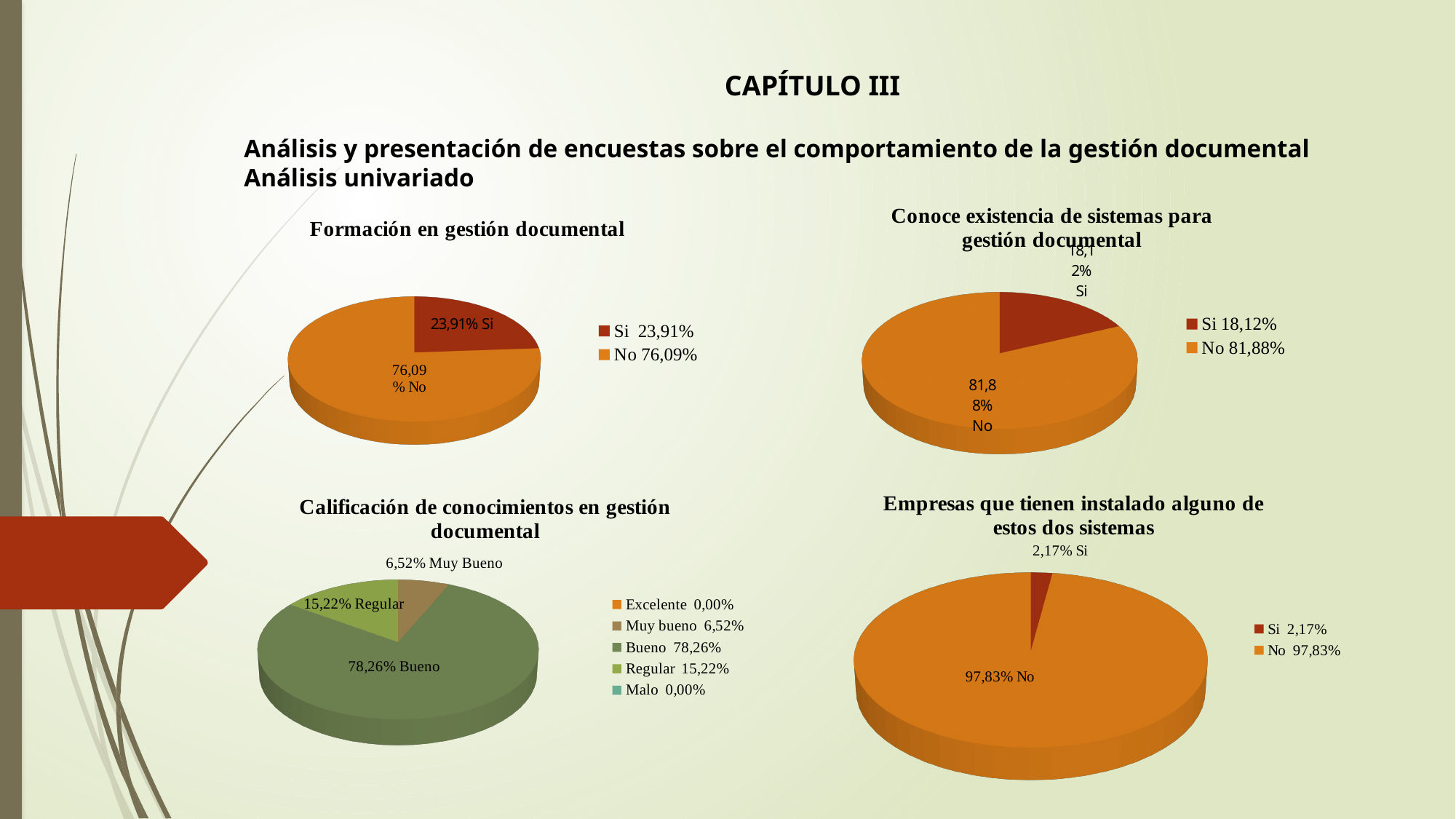
In the 'Empresas que tienen instalado alguno de estos dos sistemas' chart, what is the value for Si? 2,17% In the 'Formación en gestión documental' chart, what is the difference between the No and Si shares? 52,18% In the 'Conoce existencia de sistemas para gestión documental' chart, what is the value for No? 81,88% How many charts are shown on the slide? 4 In the 'Conoce existencia de sistemas para gestión documental' chart, what is the value for Si? 18,12% In the 'Calificación de conocimientos en gestión documental' chart, what is the value for Regular? 15,22% In the 'Formación en gestión documental' chart, what share of respondents answered No? 76,09% In the 'Calificación de conocimientos en gestión documental' chart, how many categories does the legend list? 5 In the 'Formación en gestión documental' chart, what share of respondents answered Si? 23,91% In the 'Calificación de conocimientos en gestión documental' chart, which category has the largest share? Bueno In the 'Empresas que tienen instalado alguno de estos dos sistemas' chart, which category is larger, Si or No? No What type of chart is 'Formación en gestión documental'? Pie chart